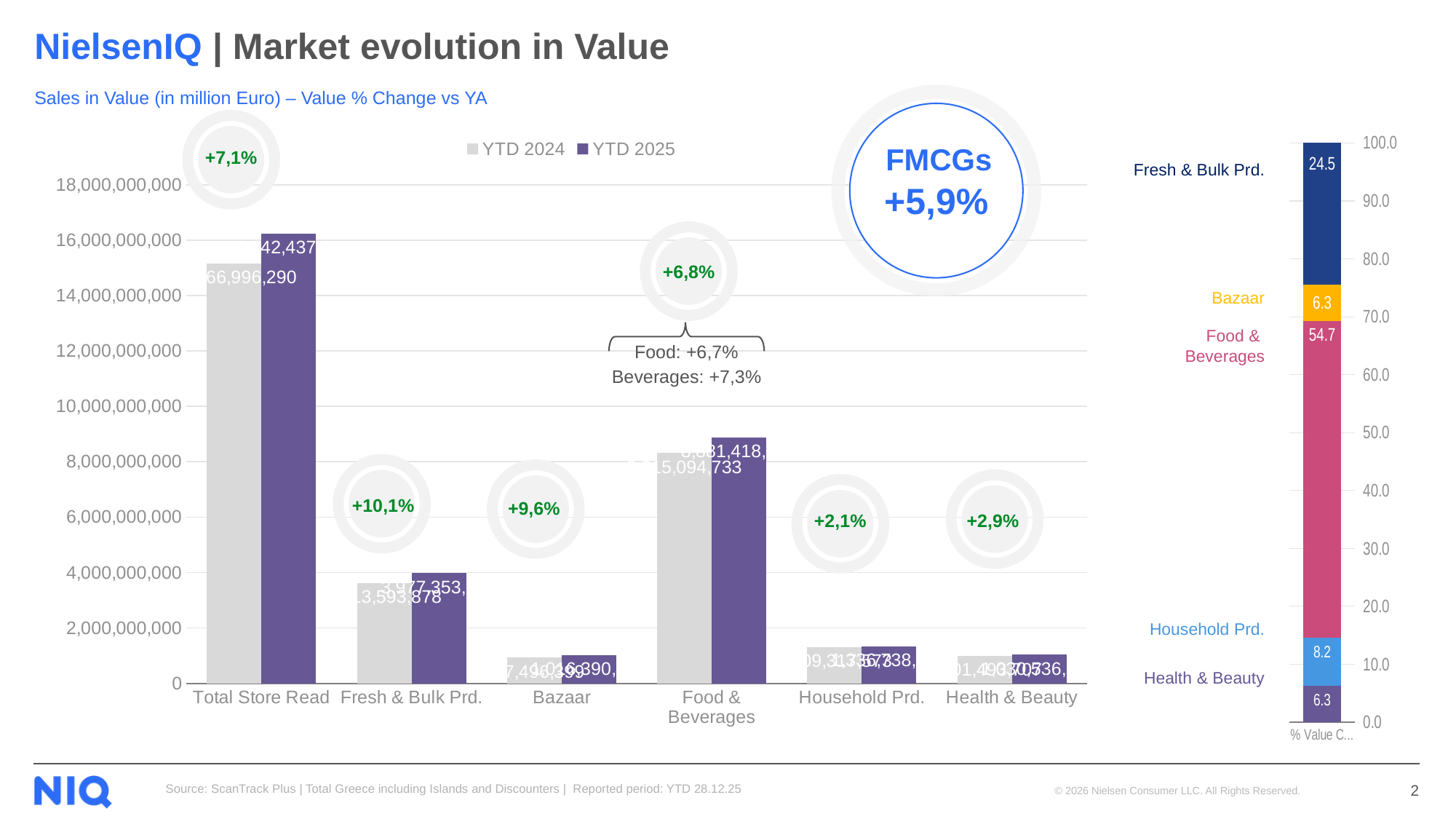
In the stacked bar chart on the right, which segment is the largest? Food & Beverages How many categories are shown on the x axis of the left bar chart? 6 What kind of chart is the left chart showing Sales in Value by category? bar chart In the left bar chart, is the YTD 2025 value for Bazaar greater or less than 2,000,000,000? less In the left bar chart, is the YTD 2024 value for Total Store Read greater or less than 16,000,000,000? less How many series does the legend of the left bar chart list? 2 What value % change vs YA is shown above the Fresh & Bulk Prd. bars in the left chart? +10,1% In the left bar chart, which category has the highest bars? Total Store Read In the stacked bar chart on the right, what is the difference between the Food & Beverages and Fresh & Bulk Prd. values? 30.2 In the left bar chart, which is larger for Fresh & Bulk Prd., the YTD 2024 or the YTD 2025 bar? YTD 2025 In the left bar chart, is the YTD 2025 value for Food & Beverages greater or less than 8,000,000,000? greater In the stacked bar chart on the right, what is the value for Food & Beverages? 54.7